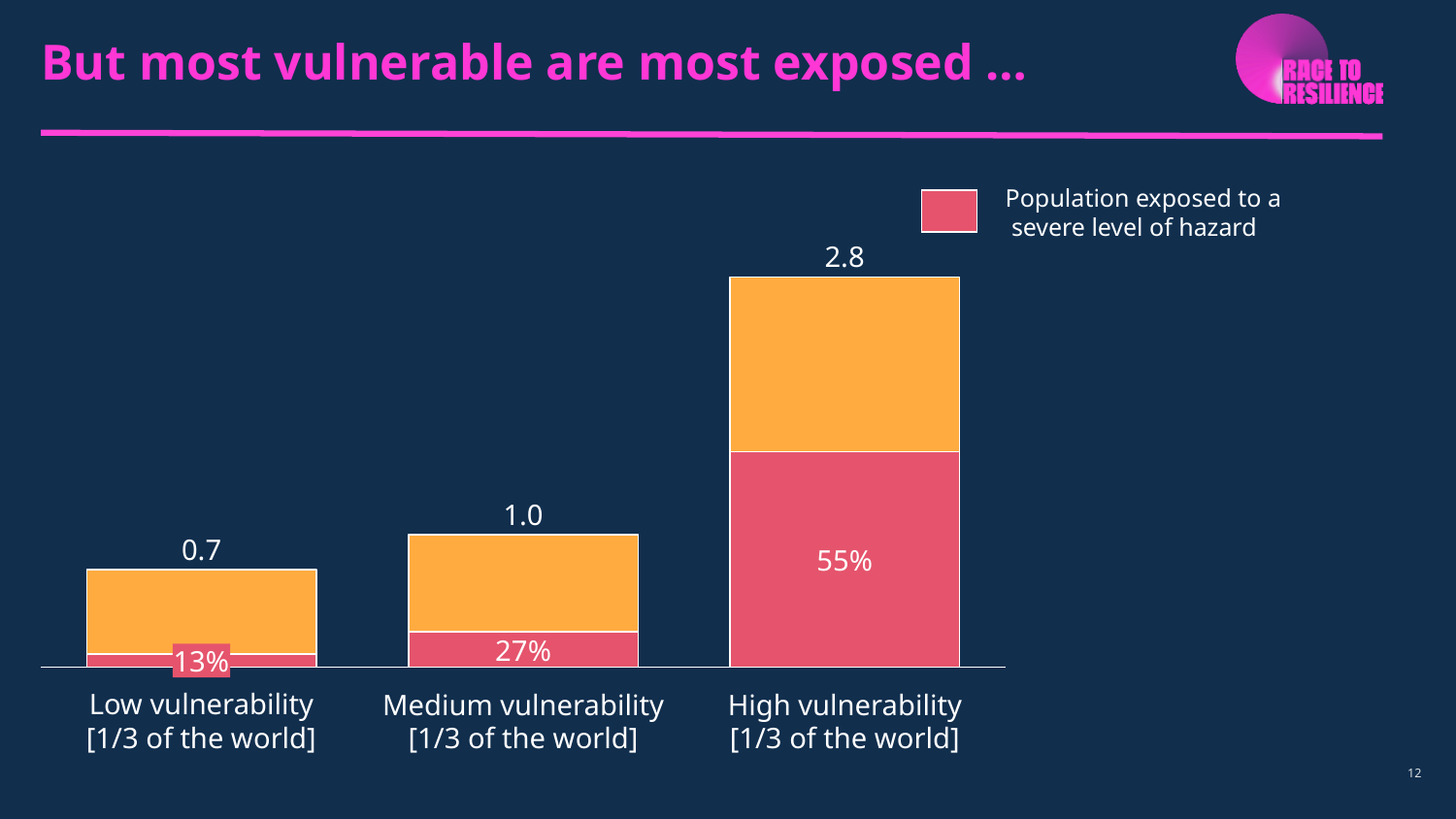
Which vulnerability category has the lowest total value? Low vulnerability What is the total value shown above the bar for Medium vulnerability? 1.0 What does the pink colour in the legend represent? Population exposed to a severe level of hazard What is the difference between the total values for High vulnerability and Medium vulnerability? 1.8 Which vulnerability category has the highest total value? High vulnerability What is the total value shown above the bar for High vulnerability? 2.8 How many vulnerability categories are shown on the x axis? 3 What percentage is labelled on the pink segment of the Low vulnerability bar? 13% Which bar has a larger total value, Low vulnerability or Medium vulnerability? Medium vulnerability What is the total value shown above the bar for Low vulnerability? 0.7 What percentage is labelled on the pink segment of the High vulnerability bar? 55% What percentage is labelled on the pink segment of the Medium vulnerability bar? 27%